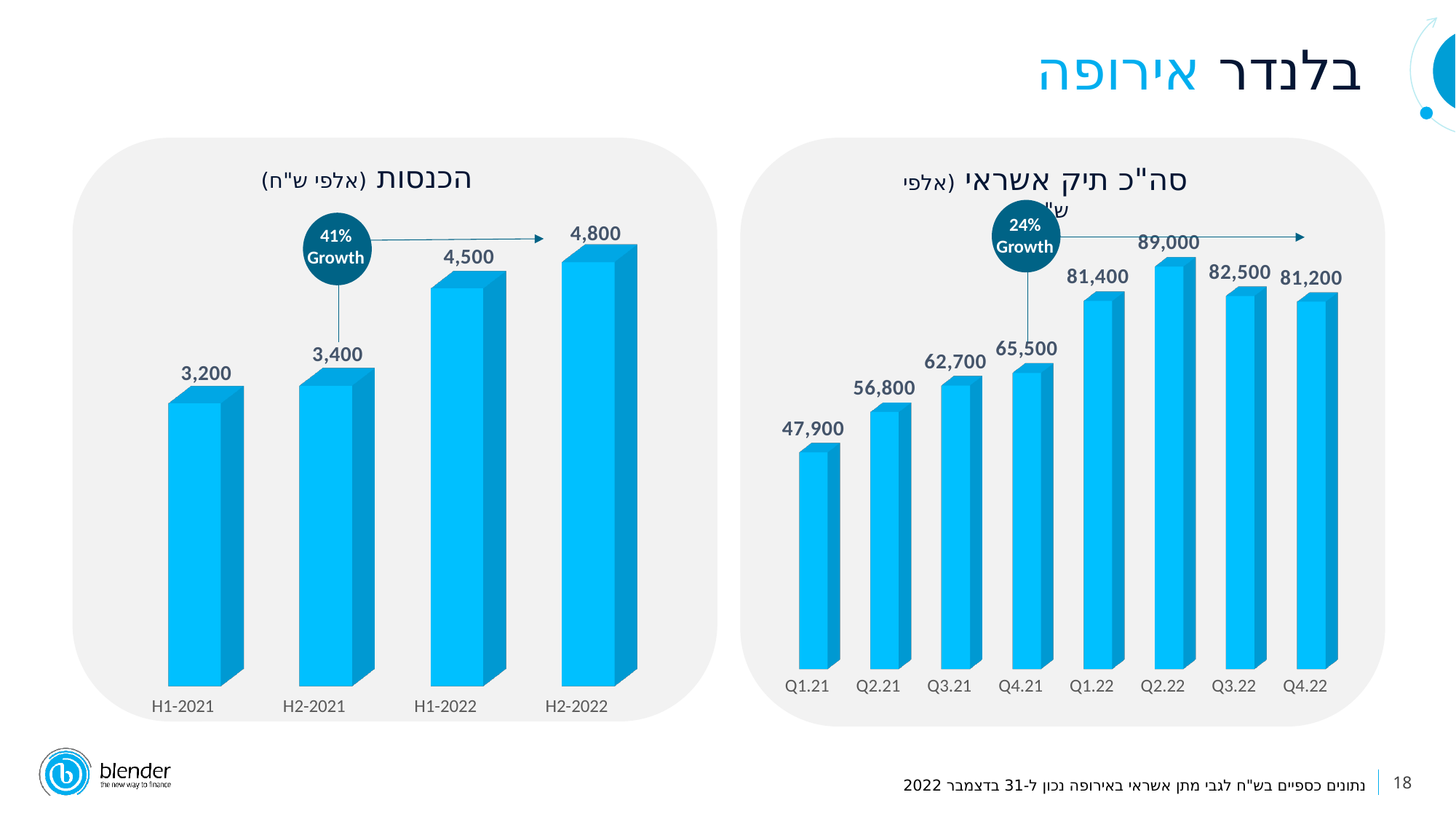
In the left chart (הכנסות), what is the difference between H2-2022 and H1-2021? 1,600 In the right chart (סה"כ תיק אשראי), which is larger, Q3.22 or Q4.22? Q3.22 In the left chart (הכנסות), how many periods are shown? 4 In the right chart (סה"כ תיק אשראי), which quarter has the highest value? Q2.22 In the right chart (סה"כ תיק אשראי), what is the value for Q3.21? 62,700 In the right chart (סה"כ תיק אשראי), which quarter has the lowest value? Q1.21 In the left chart (הכנסות), which period has the highest value? H2-2022 What kind of chart is the left chart (הכנסות)? bar chart In the right chart (סה"כ תיק אשראי), how many quarters are shown? 8 In the left chart (הכנסות), what is the value for H1-2022? 4,500 In the left chart (הכנסות), do the values rise or fall from H1-2021 to H2-2022? rise In the right chart (סה"כ תיק אשראי), what is the difference between Q2.22 and Q1.22? 7,600